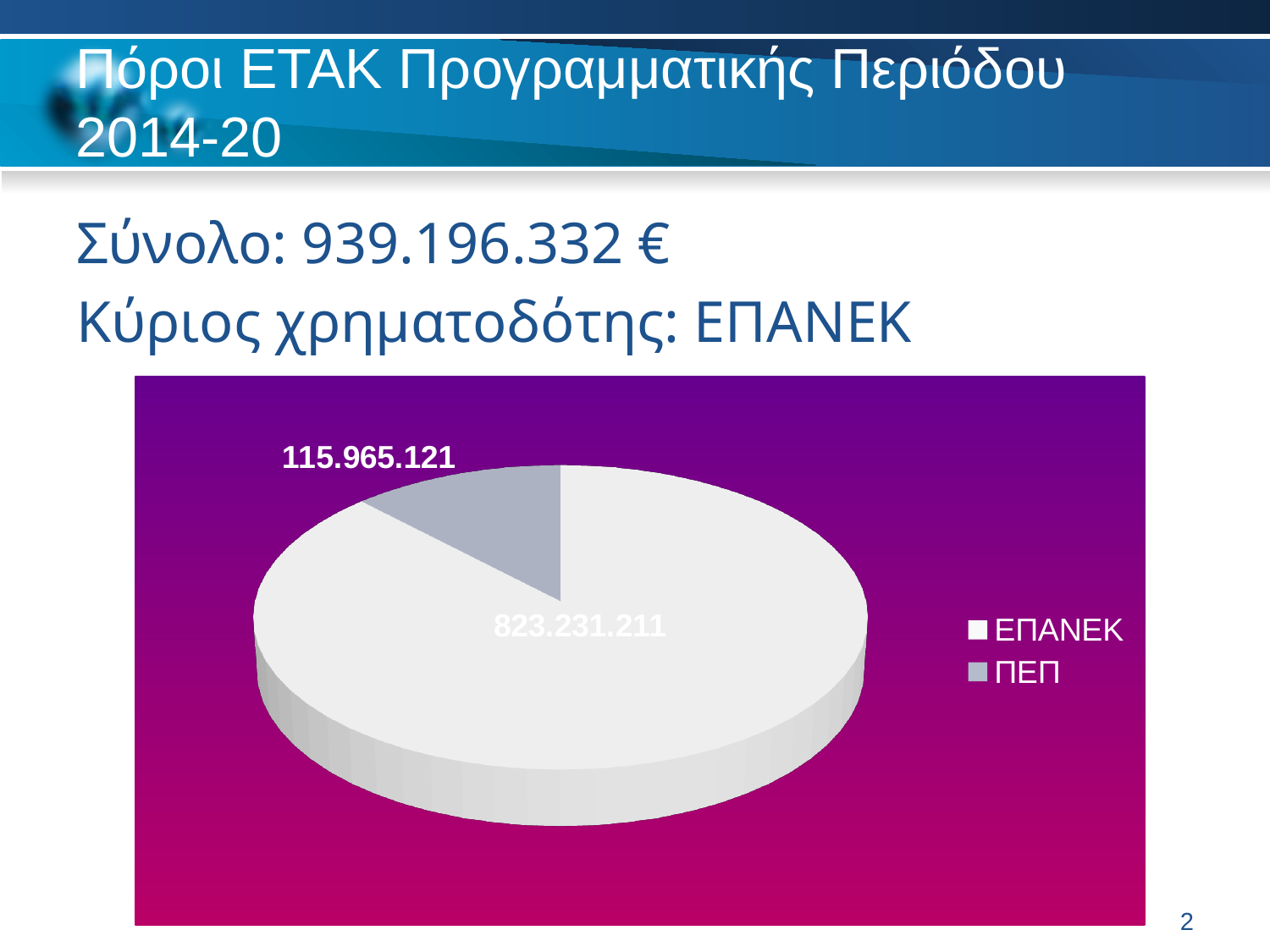
What is the total of the two slices in the pie chart? 939.196.332 What is the value for ΕΠΑΝΕΚ in the pie chart? 823.231.211 What is the value for ΠΕΠ in the pie chart? 115.965.121 Which is larger, the value for ΕΠΑΝΕΚ or the value for ΠΕΠ? ΕΠΑΝΕΚ Which legend entry is shown in grey in the pie chart? ΠΕΠ How many entries does the legend of the pie chart list? 2 Which slice of the pie chart is the largest? ΕΠΑΝΕΚ Which slice of the pie chart is the smallest? ΠΕΠ What is the difference between the ΕΠΑΝΕΚ value and the ΠΕΠ value? 707.266.090 What kind of chart is shown on the slide? pie chart How many slices does the pie chart have? 2